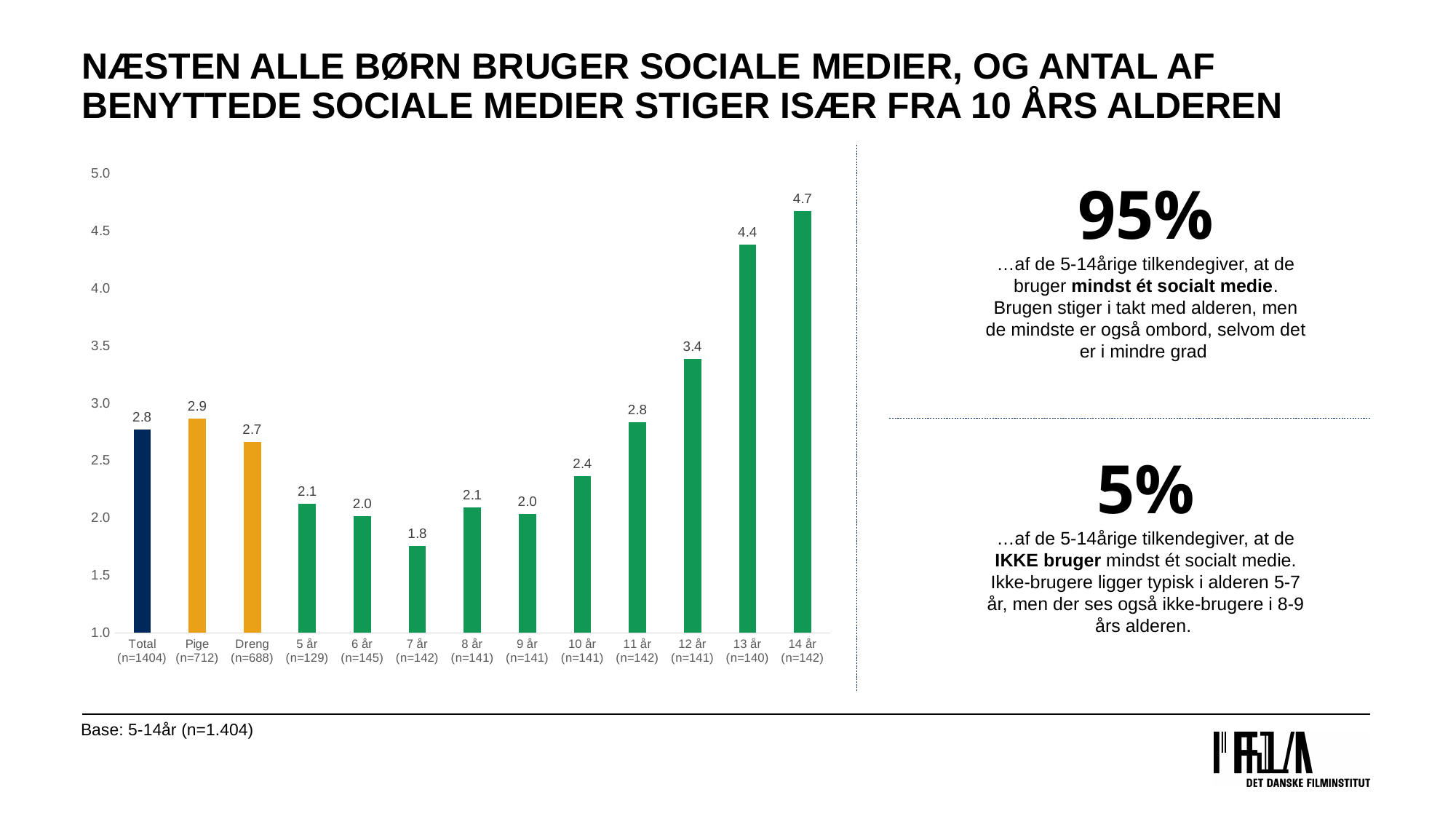
What is the value for 14 år? 4.7 What is the value for Pige? 2.9 Do the values rise or fall from 10 år to 14 år? rise What is the value for 7 år? 1.8 What kind of chart is shown? bar chart What colour are the bars for Pige and Dreng? orange Which category has the lowest value? 7 år Which is larger, the value for Pige or the value for Dreng? Pige What is the difference between the values for 14 år and 13 år? 0.3 Which category has the highest value? 14 år Is the value for 12 år greater or less than 3.0? greater How many categories are shown on the x axis? 13